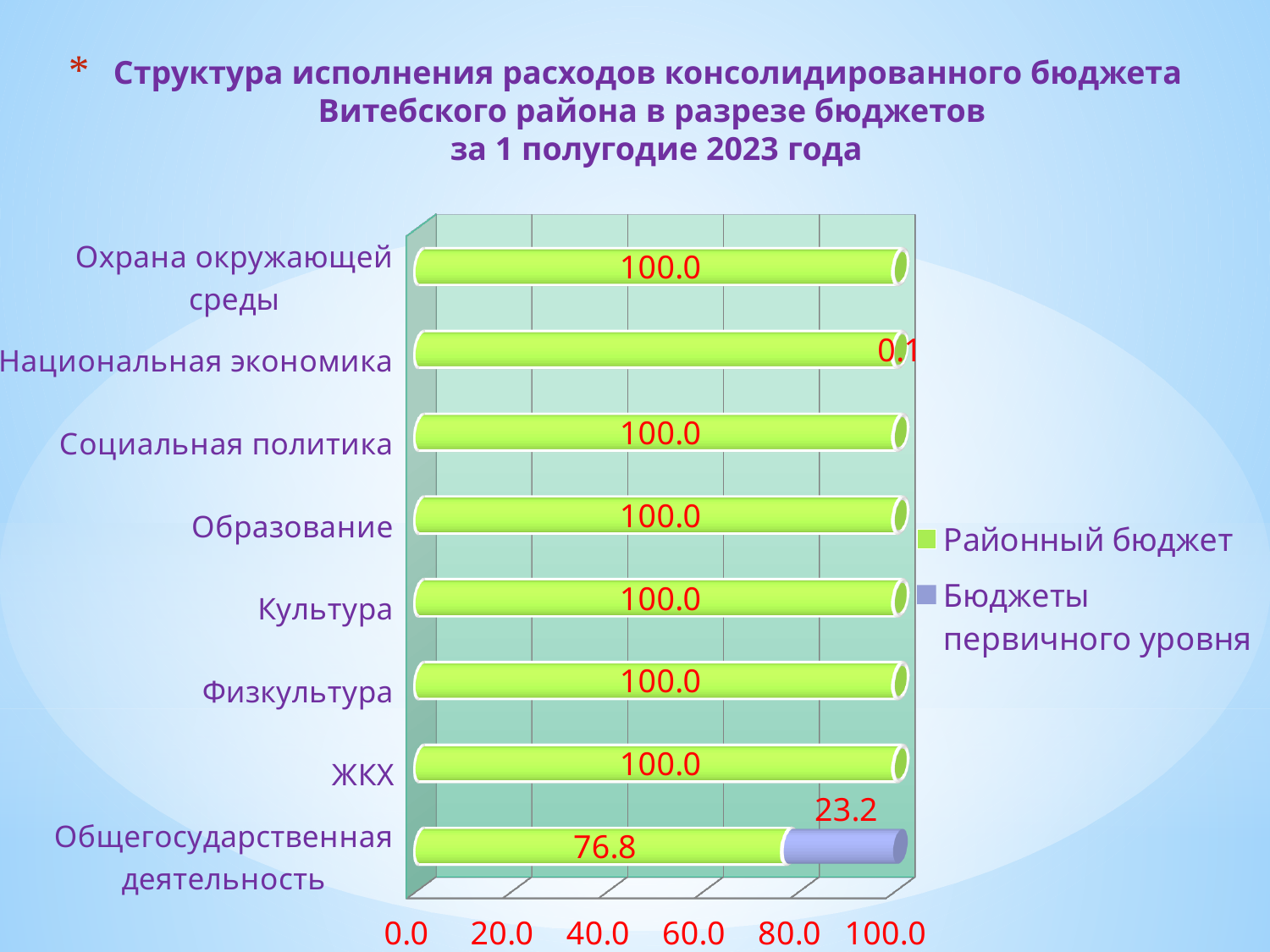
Which is larger for Районный бюджет: Культура or Общегосударственная деятельность? Культура What is the total of the stacked bar for Общегосударственная деятельность? 100.0 What is the value of Районный бюджет for Общегосударственная деятельность? 76.8 How many categories are shown on the chart? 8 What are the two entries in the chart legend? Районный бюджет; Бюджеты первичного уровня What is the value of Районный бюджет for Образование? 100.0 What kind of chart is shown on the slide? bar chart How many series does the legend list? 2 Is the value of Районный бюджет for Общегосударственная деятельность greater or less than 80.0? less What is the value of Бюджеты первичного уровня for Общегосударственная деятельность? 23.2 Which category has the lowest value for Районный бюджет? Общегосударственная деятельность What is the difference between the Районный бюджет and Бюджеты первичного уровня values for Общегосударственная деятельность? 53.6